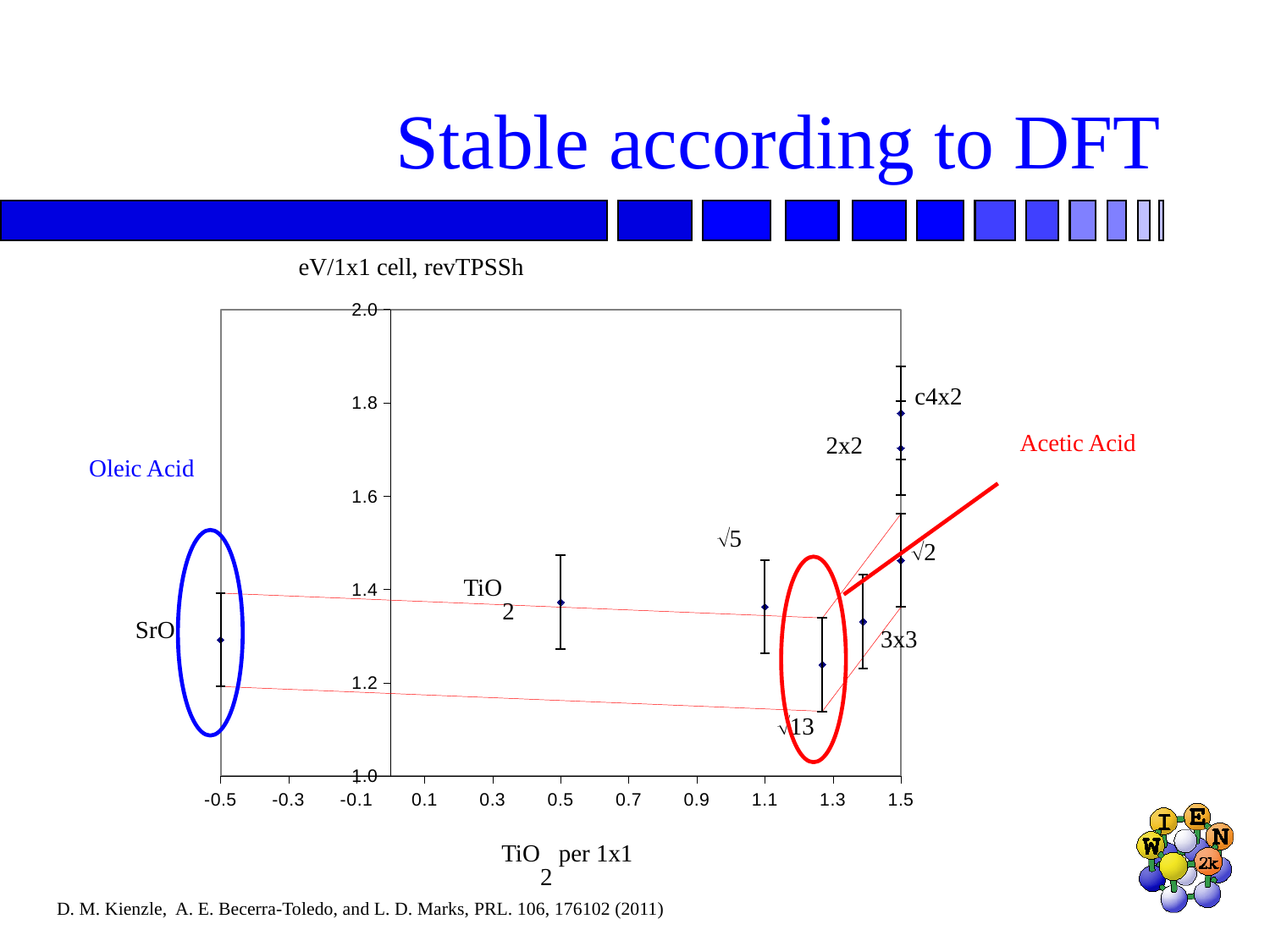
Which has the larger value, √2 or 3x3? √2 Which has the larger value, 2x2 or √13? 2x2 Is the value for √13 greater or less than 1.4? less Is the value for c4x2 greater or less than 1.6? greater Which labelled point has the lowest value on the vertical axis? √13 Which labelled point has the highest value on the vertical axis? c4x2 Is the value for SrO greater or less than 1.4? less How many labelled data points are plotted on the chart? 8 What kind of chart is shown on the slide? scatter chart What is the title of the vertical axis? eV/1x1 cell, revTPSSh